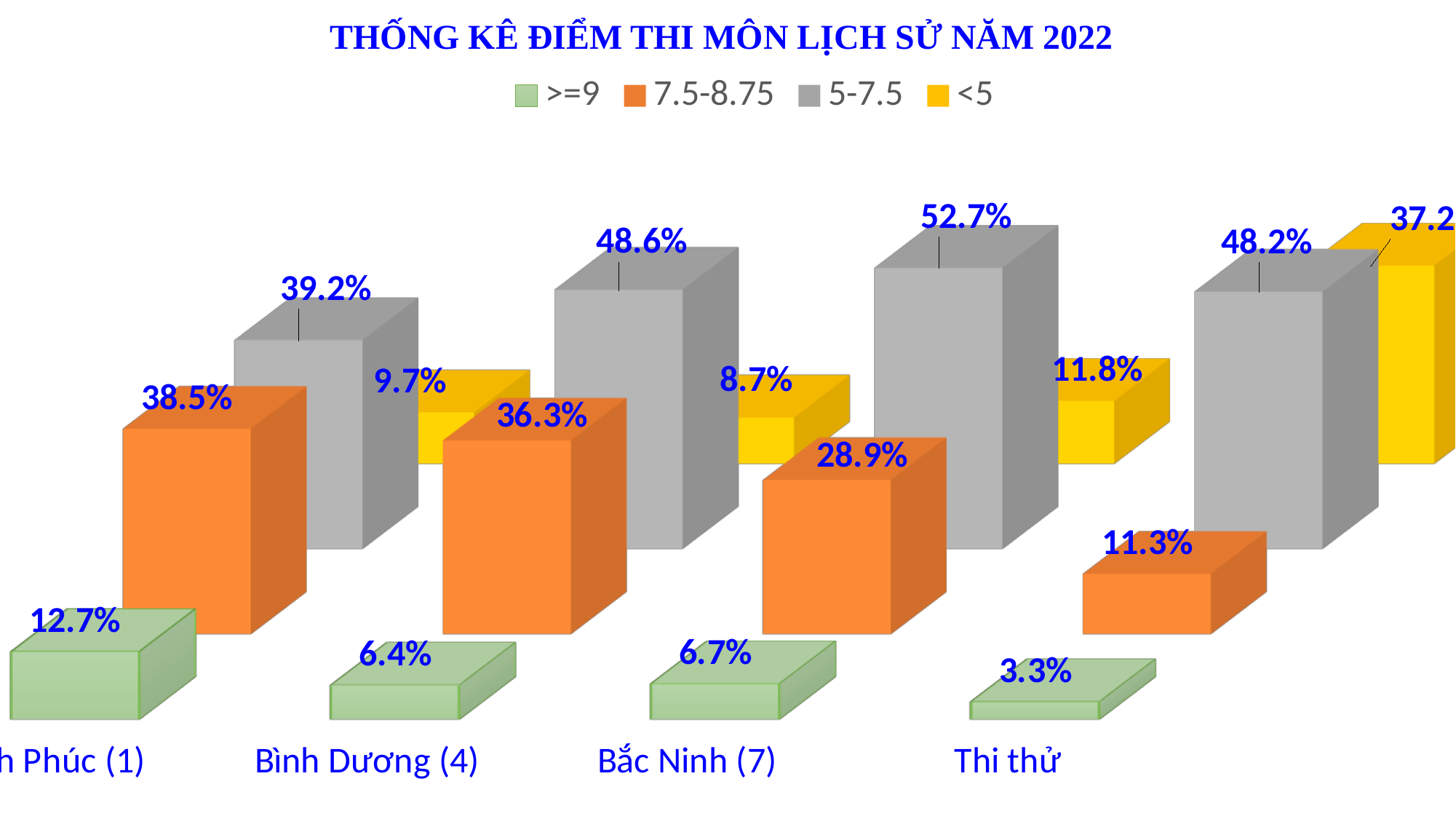
What is the difference between the 7.5-8.75 values for Bình Dương (4) and Bắc Ninh (7)? 7.4 percentage points What is the title of the chart? THỐNG KÊ ĐIỂM THI MÔN LỊCH SỬ NĂM 2022 What is the value of the >=9 series for Bắc Ninh (7)? 6.7% How many categories are shown along the x axis? 4 Do the values of the 7.5-8.75 series rise or fall from left to right along the x axis? Fall Which category has the highest value in the 5-7.5 series? Bắc Ninh (7) What is the value of the 5-7.5 series for Bình Dương (4)? 48.6% How many series does the legend list? 4 What kind of chart is shown on the slide? Bar chart Which is larger, the <5 value for Bắc Ninh (7) or for Bình Dương (4)? Bắc Ninh (7) Which category has the lowest value in the >=9 series? Thi thử What is the value of the 7.5-8.75 series for Thi thử? 11.3%